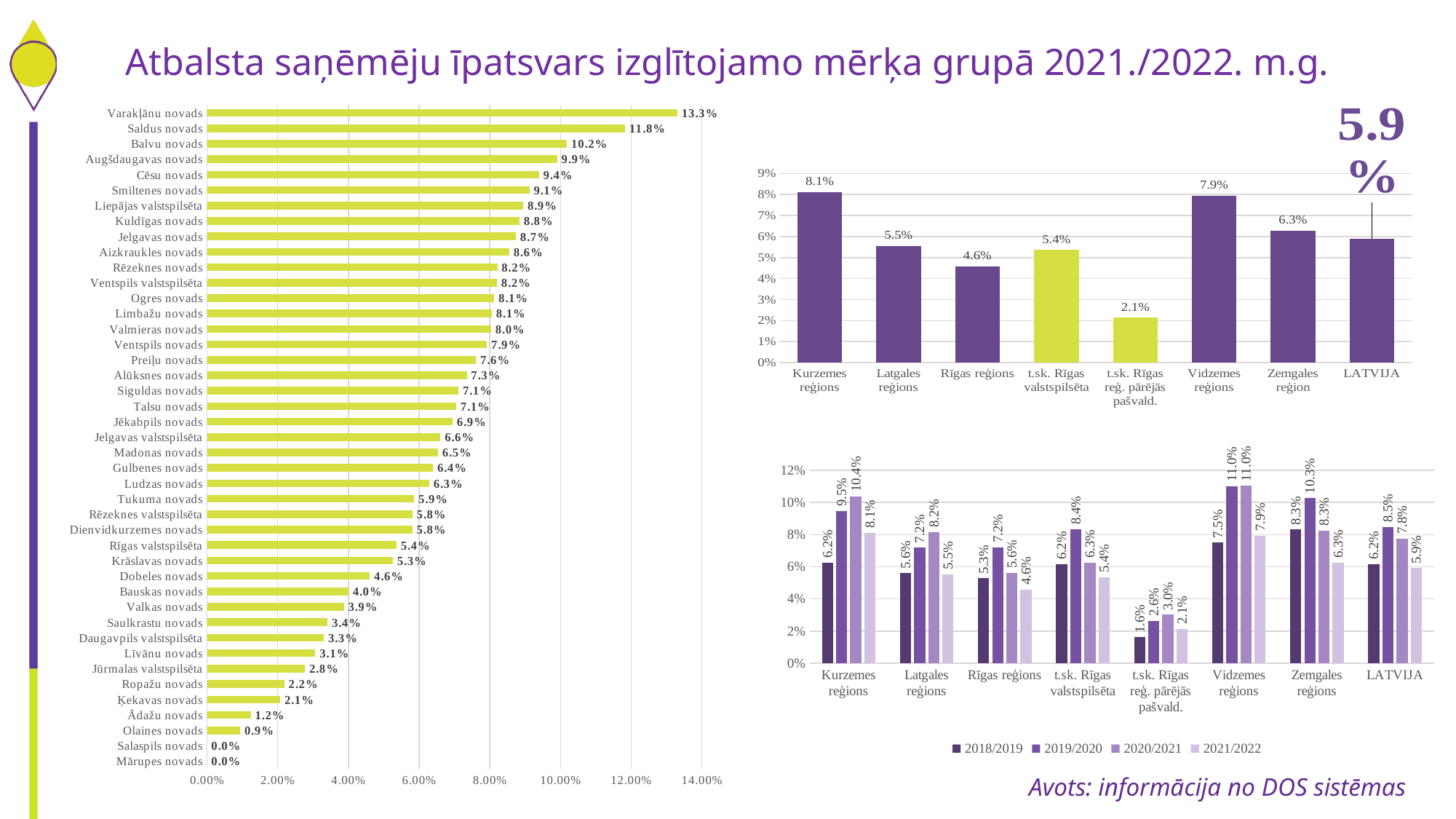
In the top-right bar chart of regions, how many categories are shown on the x axis? 8 In the top-right bar chart of regions, which category has the lowest value? t.sk. Rīgas reģ. pārējās pašvald. In the left bar chart of municipalities, what is the value for Rīgas valstspilsēta? 5.4% In the left bar chart of municipalities, what is the value for Varakļānu novads? 13.3% In the left bar chart of municipalities, which municipality has the highest value? Varakļānu novads In the top-right bar chart of regions, what is the value for Kurzemes reģions? 8.1% In the bottom-right grouped bar chart, what is the value for Vidzemes reģions in 2019/2020? 11.0% In the bottom-right grouped bar chart, what is the difference between the 2018/2019 and 2021/2022 values for Zemgales reģions? 2.0% In the left bar chart of municipalities, which is larger, the value for Cēsu novads or the value for Tukuma novads? Cēsu novads In the bottom-right grouped bar chart, how many series does the legend list? 4 In the left bar chart of municipalities, what is the difference between Saldus novads and Balvu novads? 1.6% In the top-right bar chart of regions, what is the value for LATVIJA? 5.9%